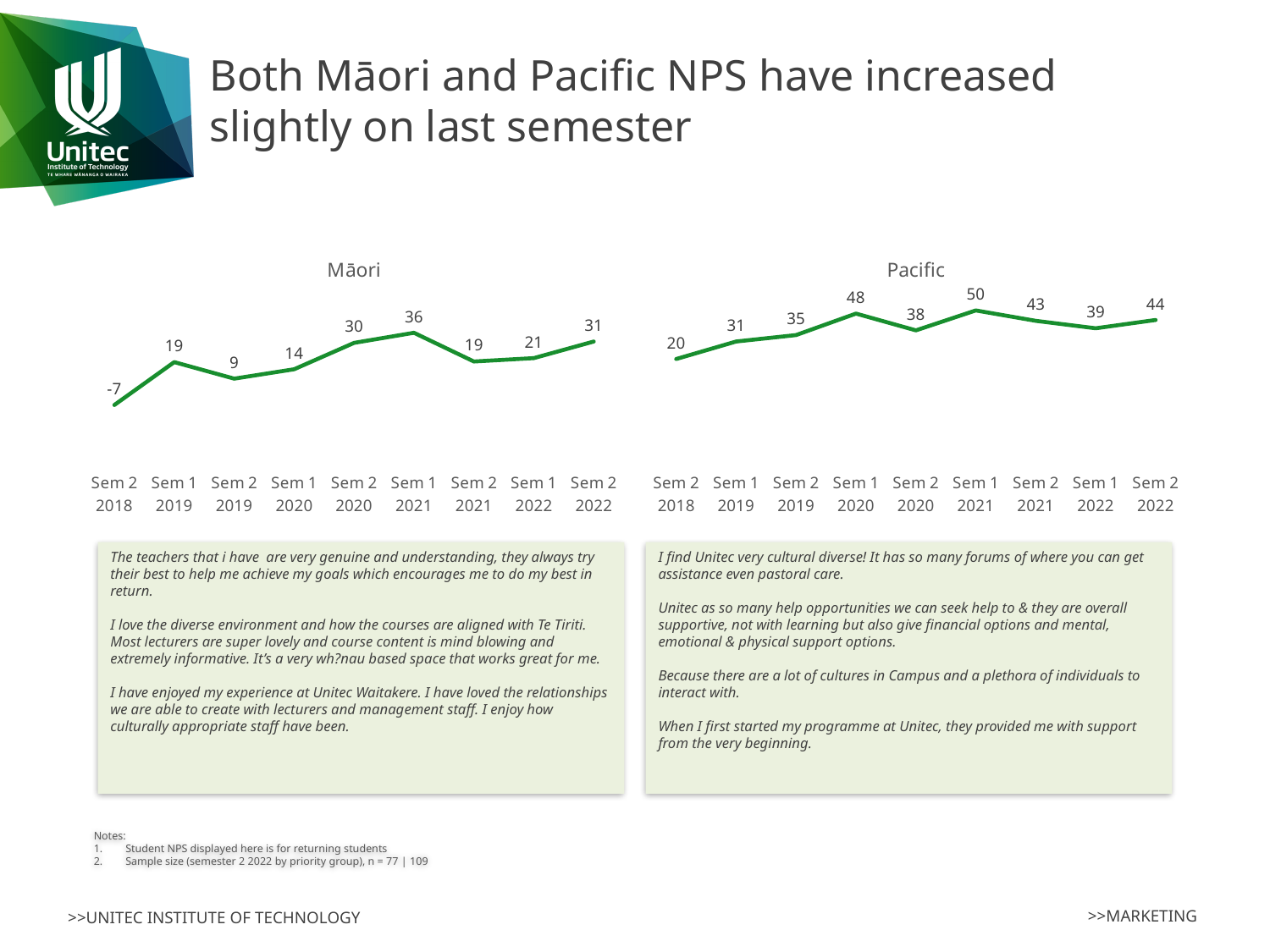
In the Pacific chart, does the NPS value rise or fall from Sem 1 2022 to Sem 2 2022? Rise In the Māori chart, which semester has the lowest NPS value? Sem 2 2018 How many data points are plotted in the Pacific chart? 9 In the Māori chart, what is the NPS value for Sem 2 2022? 31 In the Māori chart, which semester has the highest NPS value? Sem 1 2021 What type of chart is the Māori chart? Line chart In the Pacific chart, what is the difference between the Sem 2 2022 value and the Sem 1 2022 value? 5 In the Māori chart, what is the difference between the Sem 2 2022 value and the Sem 2 2018 value? 38 What is the title of the chart on the right side of the slide? Pacific In the Pacific chart, which semester has the highest NPS value? Sem 1 2021 Which is larger: the Māori NPS for Sem 2 2022 or the Pacific NPS for Sem 2 2022? Pacific In the Pacific chart, what is the NPS value for Sem 1 2021? 50